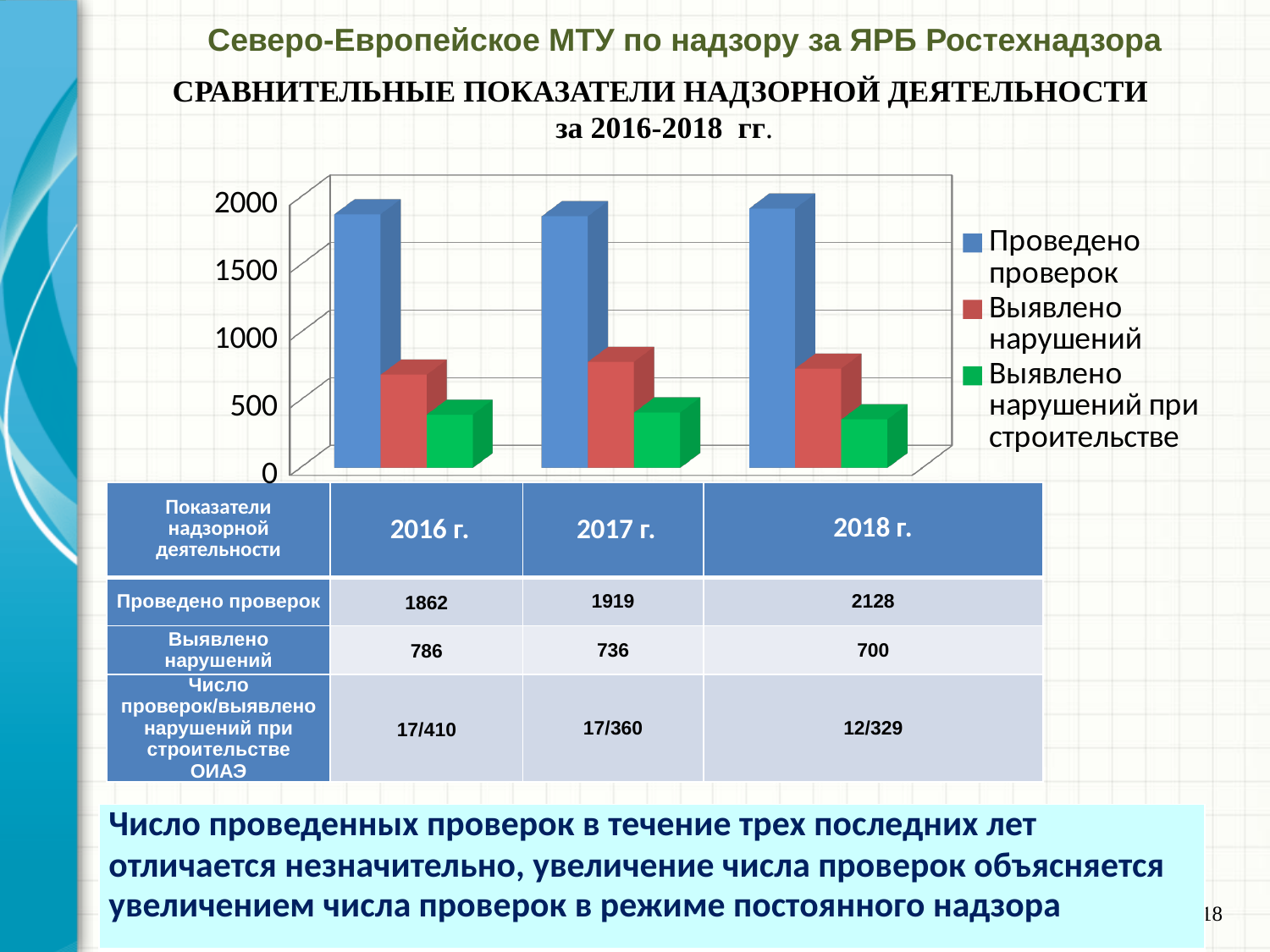
Does Выявлено нарушений rise or fall from 2016 г. to 2018 г.? fall Is the value for Выявлено нарушений при строительстве in 2016 г. greater or less than 500? less How many series does the chart legend list? 3 What is the difference between Проведено проверок in 2018 г. and in 2016 г.? 266 In which year is Проведено проверок the highest? 2018 г. What is the value of Выявлено нарушений for 2016 г.? 786 In which year is Выявлено нарушений the lowest? 2018 г. Which colour represents Проведено проверок in the chart legend? blue By how much did Выявлено нарушений decrease from 2016 г. to 2017 г.? 50 What is the value of Проведено проверок for 2018 г.? 2128 How many groups of bars (years) are plotted in the chart? 3 What kind of chart is shown on the slide? bar chart